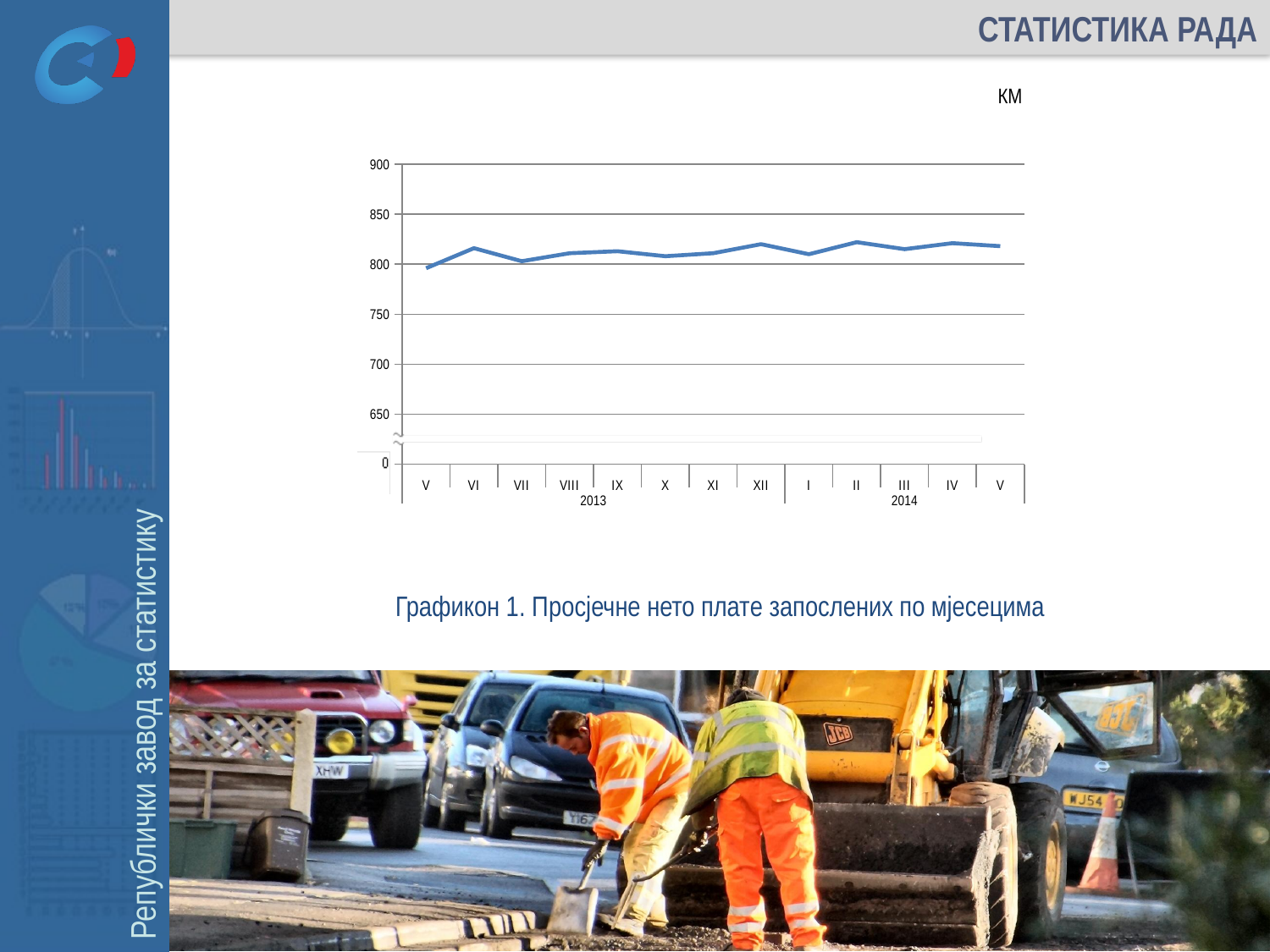
Is the value for II 2014 greater or less than 800? greater Which is larger, the value for V 2013 or the value for VI 2013? VI 2013 What unit is indicated above the chart? KM Does the value rise or fall from VI 2013 to VII 2013? fall Is the value for XII 2013 greater or less than 850? less Is the value for IX 2013 greater or less than 850? less What kind of chart is shown on the slide? line chart Which is larger, the value for VII 2013 or the value for XII 2013? XII 2013 Does the value rise or fall from V 2013 to VI 2013? rise How many monthly data points are plotted on the chart? 13 What is the title of the chart? Графикон 1. Просјечне нето плате запослених по мјесецима